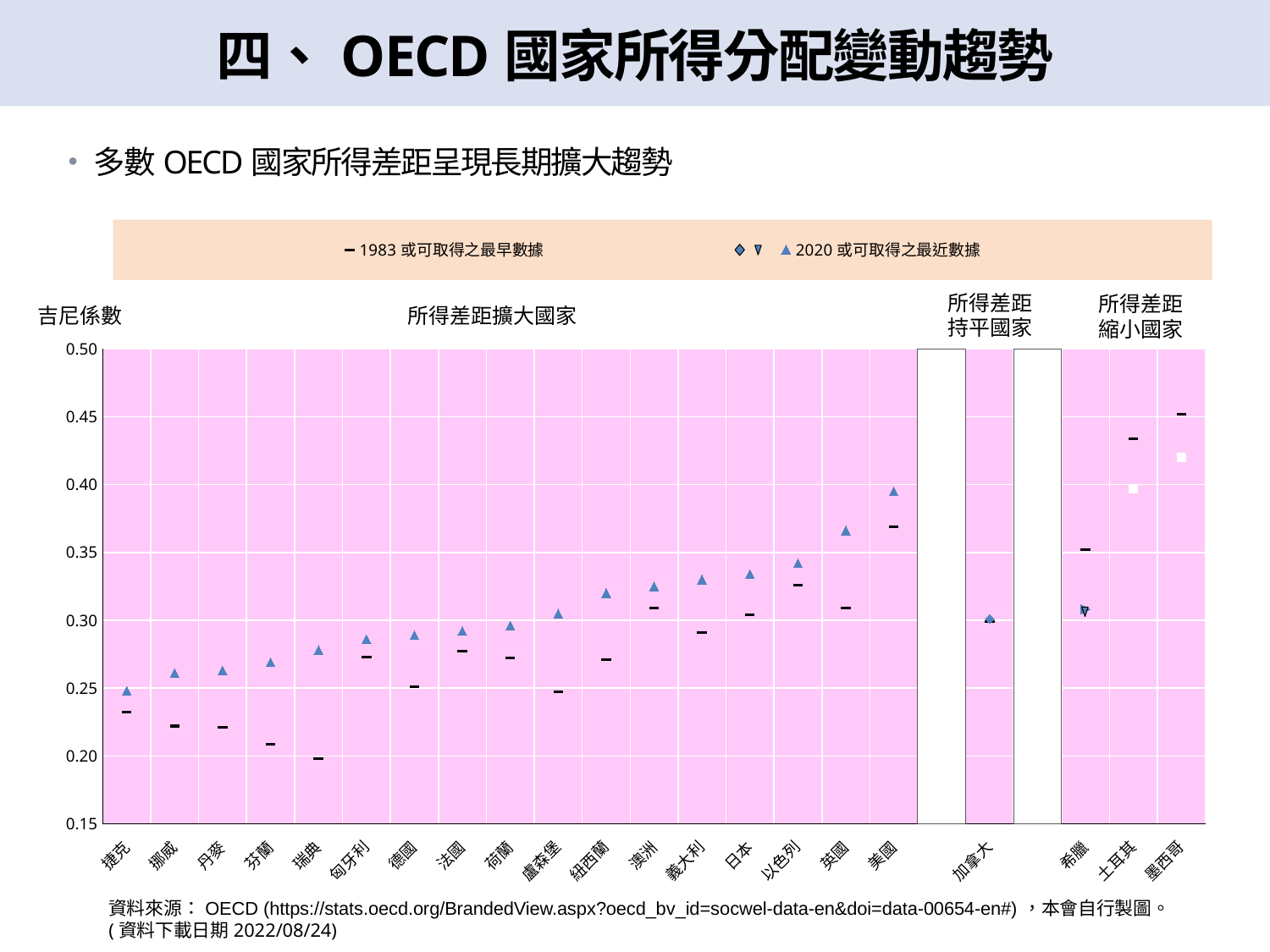
Which country has the highest 2020 (或可取得之最近數據) value among the 所得差距擴大國家 group? 美國 What kind of chart is shown on the slide? scatter chart How many data series does the chart legend list? 2 Which country has the lowest 2020 (或可取得之最近數據) value among the 所得差距擴大國家 group? 捷克 Is the 1983 value for 瑞典 greater or less than 0.25? less Which country has the highest 1983 (或可取得之最早數據) value on the chart? 墨西哥 Is the 2020 value for 美國 greater or less than 0.35? greater Is the 1983 value for 土耳其 greater or less than 0.40? greater For 德國, which is larger: the 1983 value or the 2020 value? 2020 Do the 2020 values rise or fall from left to right across the 所得差距擴大國家 group? rise How many countries are shown along the x axis of the chart? 21